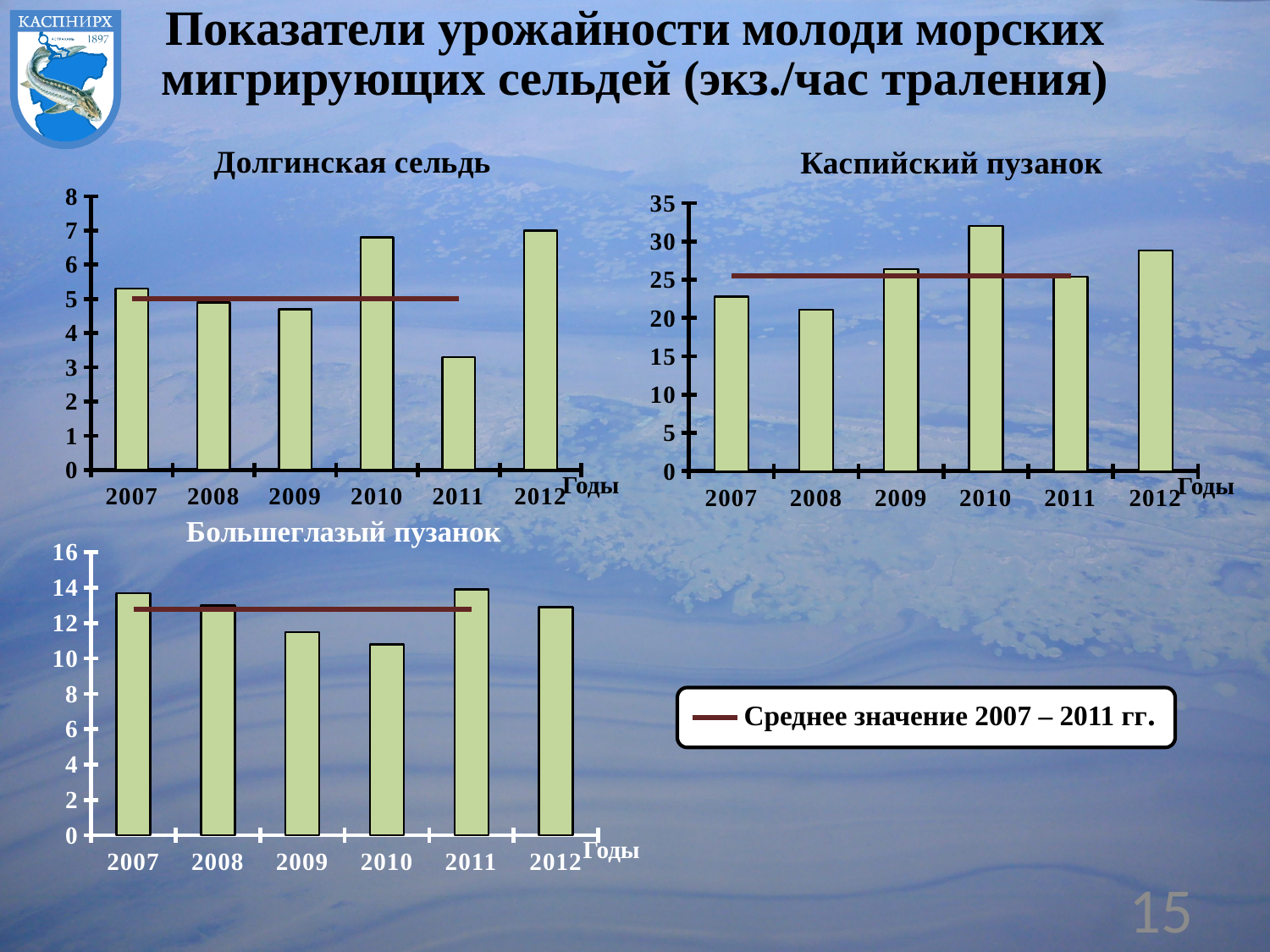
In the "Каспийский пузанок" chart, is the value for 2010 greater or less than 30? greater In the "Долгинская сельдь" chart, is the value for 2010 greater or less than 6? greater In the "Каспийский пузанок" chart, which is larger, the value for 2012 or the value for 2011? 2012 In the "Долгинская сельдь" chart, which year has the lowest value? 2011 In the "Каспийский пузанок" chart, which year has the lowest value? 2008 In the "Каспийский пузанок" chart, which year has the highest value? 2010 How many years are shown on the x axis of the "Большеглазый пузанок" chart? 6 In the "Долгинская сельдь" chart, is the value for 2011 greater or less than 4? less What kind of chart is the "Долгинская сельдь" chart? bar chart According to the legend on the slide, what does the horizontal line in each chart represent? Среднее значение 2007 – 2011 гг. In the "Долгинская сельдь" chart, which is larger, the value for 2010 or the value for 2009? 2010